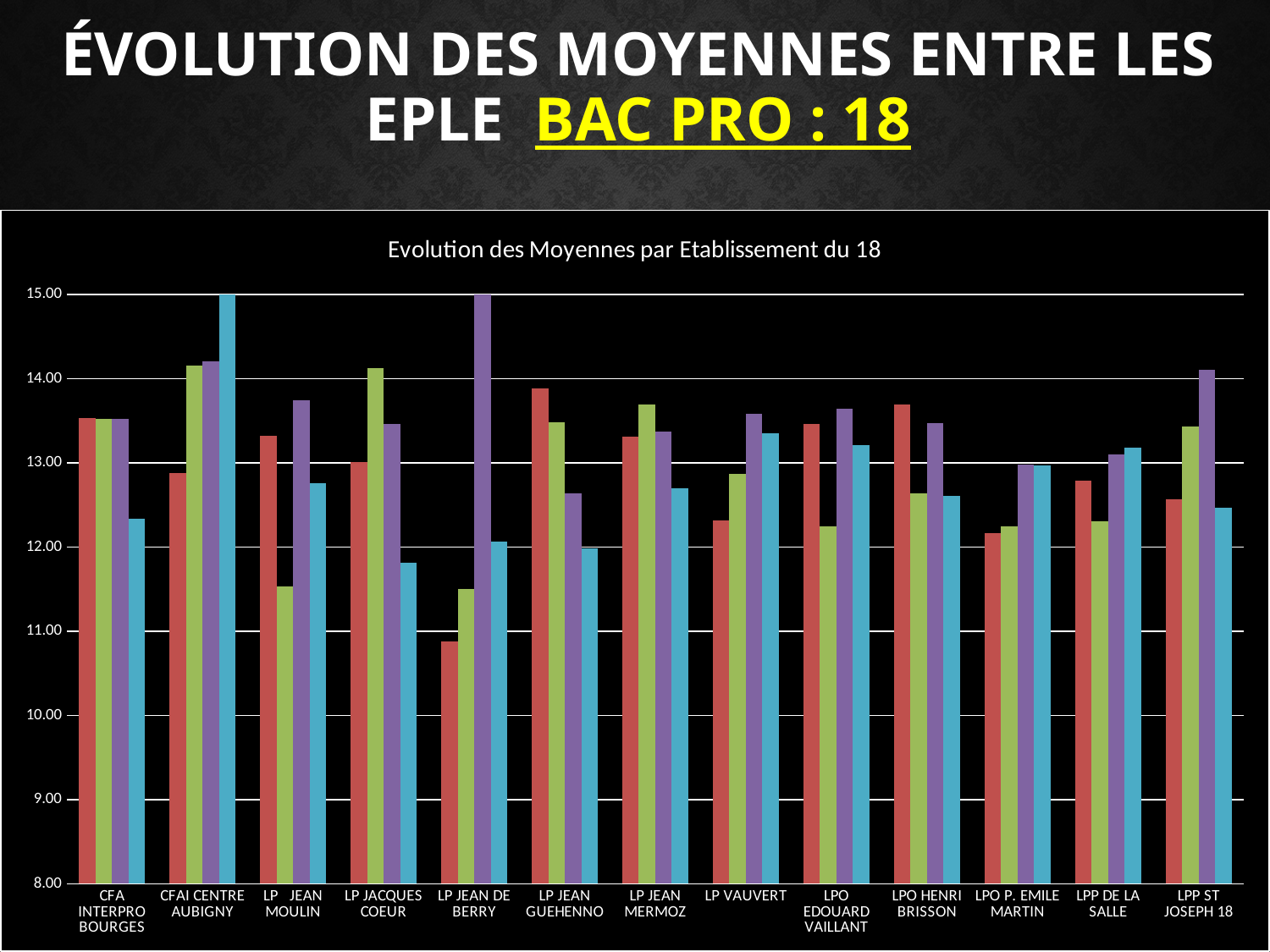
Which establishment has the lowest bar in the chart? LP JEAN DE BERRY Which is larger: the blue bar for CFAI CENTRE AUBIGNY or the blue bar for LP JEAN DE BERRY? CFAI CENTRE AUBIGNY How many bars are plotted for each establishment in the chart? 4 What kind of chart is shown on the slide? bar chart Is the value of the red bar for LP JEAN GUEHENNO greater or less than 13.00? greater Is the value of the green bar for LP JEAN MOULIN greater or less than 12.00? less Is the value of the blue bar for CFAI CENTRE AUBIGNY greater or less than 14.00? greater Which is larger: the red bar for LP JEAN GUEHENNO or the red bar for LPO P. EMILE MARTIN? LP JEAN GUEHENNO How many establishments (categories) are shown on the x axis of the chart? 13 What is the title of the chart? Evolution des Moyennes par Etablissement du 18